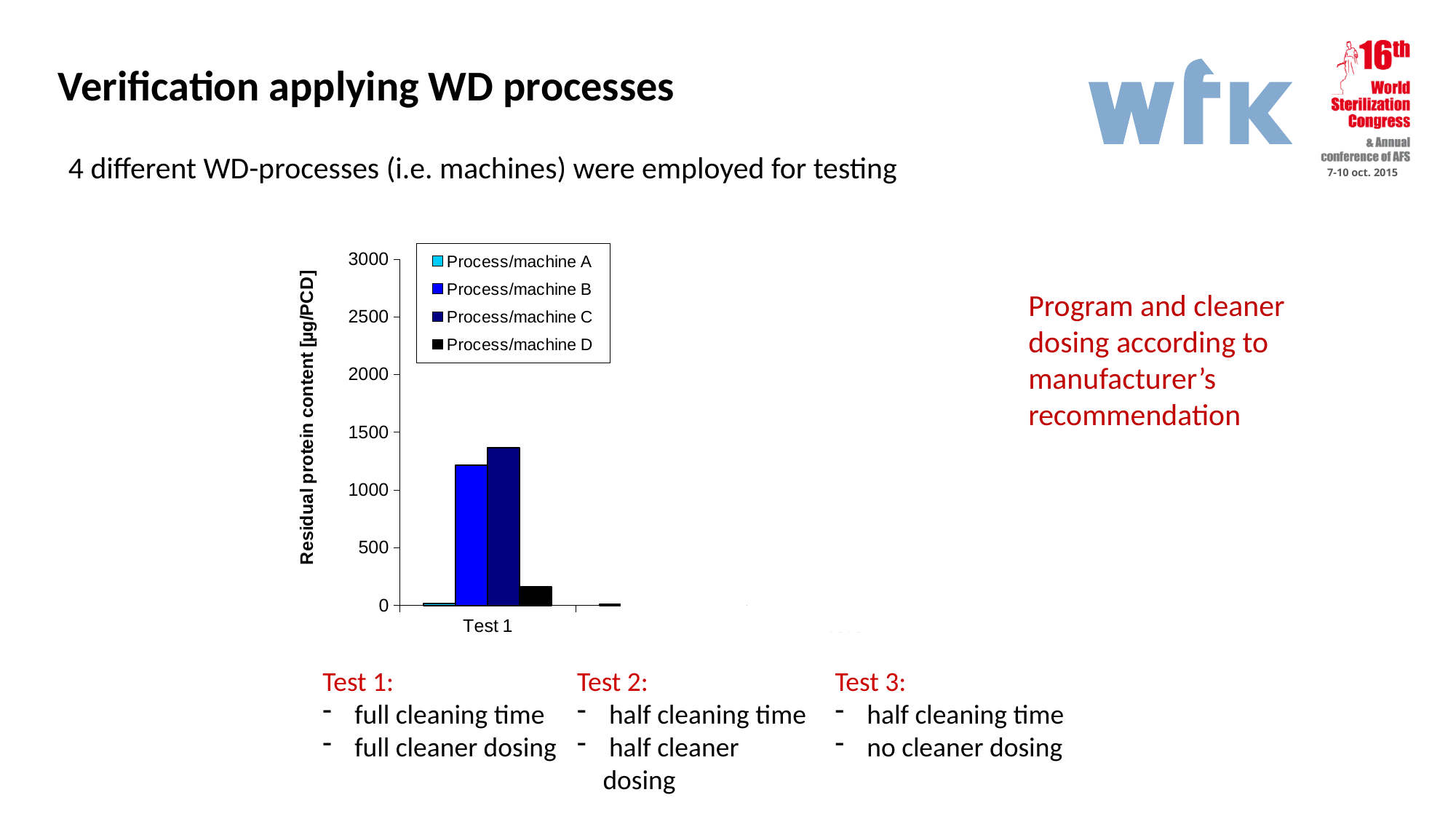
For Test 1, is the value for Process/machine B greater or less than 1000? greater Which process/machine has the highest residual protein content for Test 1? Process/machine C For Test 1, which is larger: the value for Process/machine D or Process/machine A? Process/machine D For Test 1, is the value for Process/machine C greater or less than 1500? less For Test 1, which is larger: the value for Process/machine B or Process/machine C? Process/machine C What kind of chart is shown on the slide? bar chart For Test 1, is the value for Process/machine D greater or less than 500? less What is the label of the y-axis of the chart? Residual protein content [µg/PCD] What is the highest tick value shown on the y-axis of the chart? 3000 Which process/machine has the lowest residual protein content for Test 1? Process/machine A How many series does the chart legend list? 4